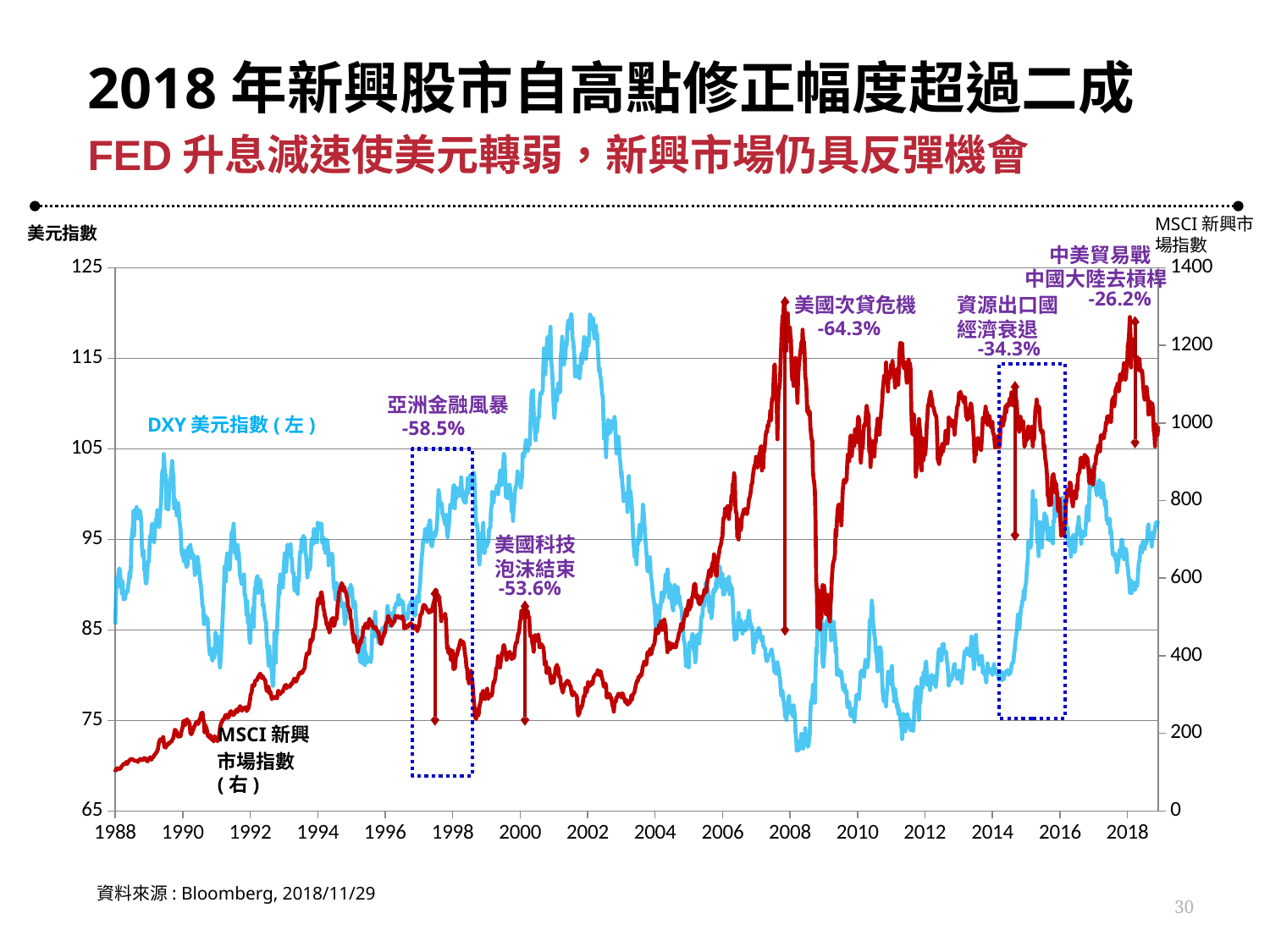
Which decline is larger in magnitude: 亞洲金融風暴 or 資源出口國經濟衰退? 亞洲金融風暴 Which labelled episode shows the smallest percentage decline in the MSCI emerging markets index? 中美貿易戰 / 中國大陸去槓桿 (-26.2%) What percentage decline is labelled for the 美國科技泡沫結束 (end of the US tech bubble)? -53.6% Which labelled episode shows the largest percentage decline in the MSCI emerging markets index? 美國次貸危機 (-64.3%) How many data series are plotted on the chart? 2 What type of chart is shown on the slide? Line chart What percentage decline is labelled for the 美國次貸危機 (US subprime crisis) on the chart? -64.3% Which series is plotted against the left axis? DXY 美元指數 What percentage decline is labelled for the 中美貿易戰 / 中國大陸去槓桿 episode? -26.2% What percentage decline is labelled for the 亞洲金融風暴 (Asian financial crisis) on the chart? -58.5% How many percentage points larger is the 美國次貸危機 decline (-64.3%) than the 中美貿易戰 decline (-26.2%)? 38.1 percentage points